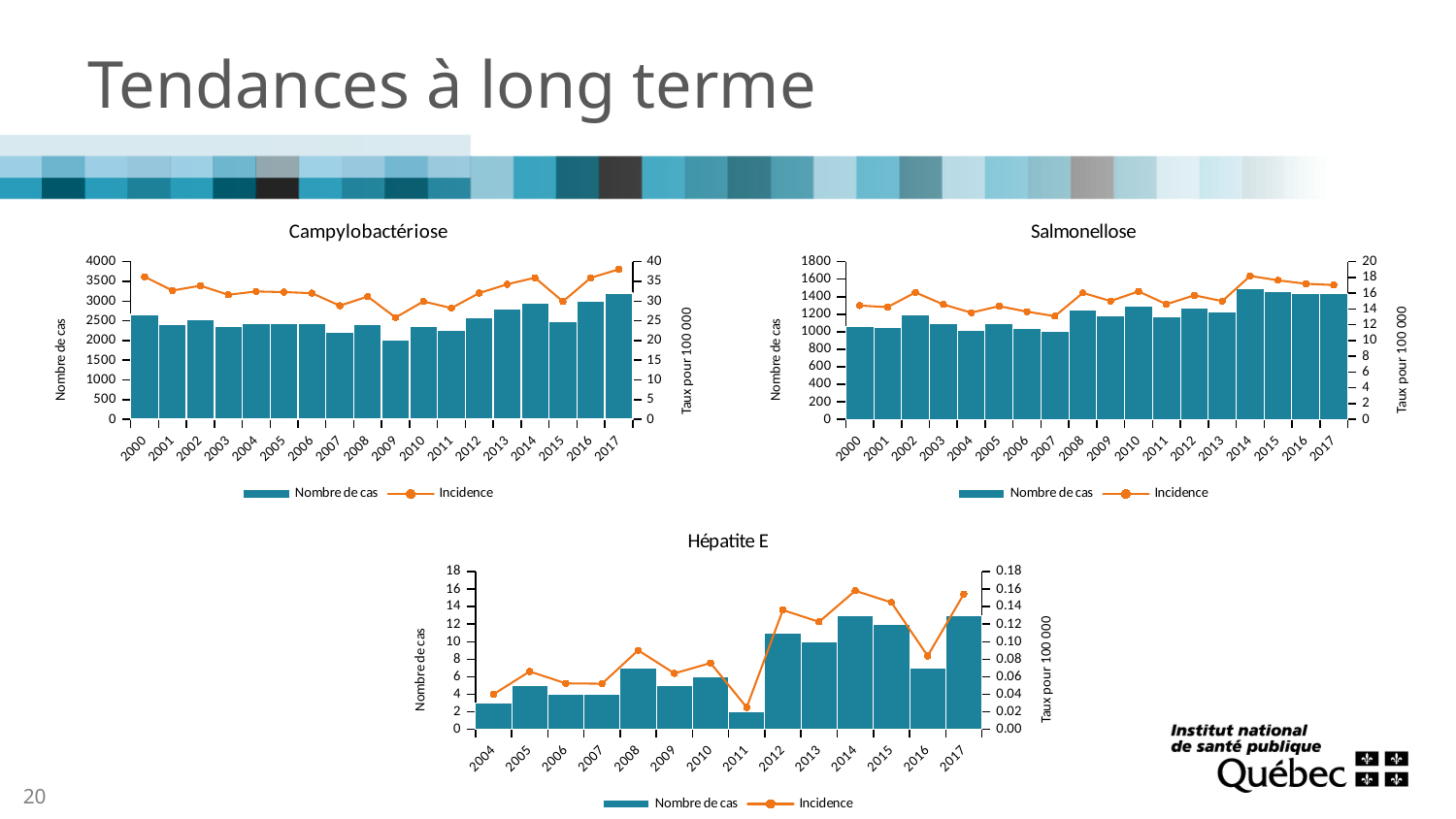
In the Campylobactériose chart, is the number of cases for 2017 greater or less than 3000? greater In the Hépatite E chart, which year has the lowest number of cases (Nombre de cas)? 2011 How many charts are shown on the slide? 3 In the Campylobactériose chart, how many years are shown on the x axis? 18 In the Salmonellose chart, is the number of cases for 2014 greater or less than 1400? greater In the Salmonellose chart, which year has the highest number of cases (Nombre de cas)? 2014 In the Campylobactériose chart, which year has the lowest number of cases (Nombre de cas)? 2009 How many series does the legend of the Salmonellose chart list? 2 In the Hépatite E chart, is the number of cases for 2012 greater or less than 10? greater In the Campylobactériose chart, which year has the highest number of cases (Nombre de cas)? 2017 What kind of chart is the Campylobactériose chart? Combined bar and line chart In the Hépatite E chart, how many years are shown on the x axis? 14